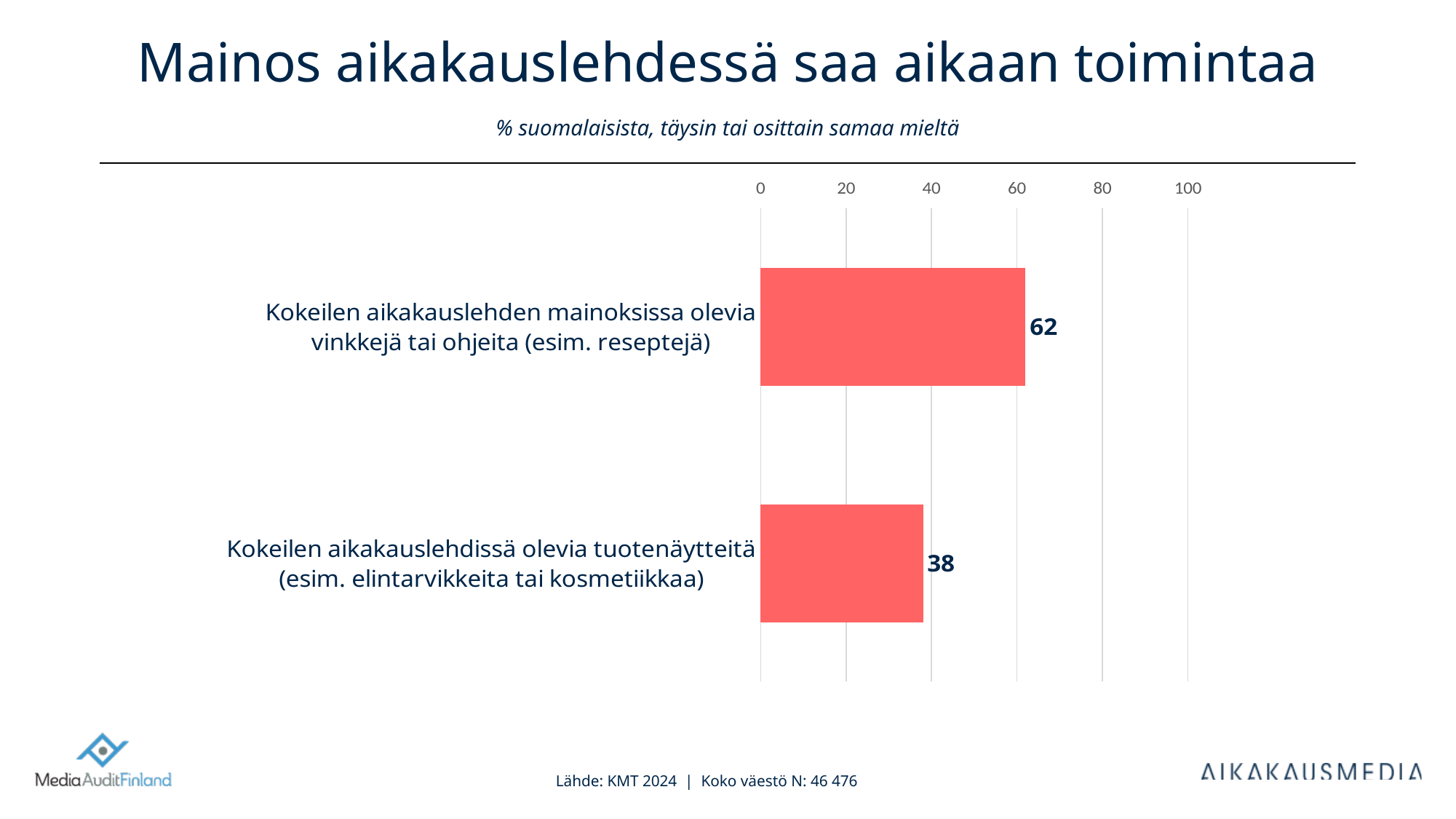
Is the value for "Kokeilen aikakauslehden mainoksissa olevia vinkkejä tai ohjeita" greater or less than 60? greater What is the value for "Kokeilen aikakauslehden mainoksissa olevia vinkkejä tai ohjeita (esim. reseptejä)"? 62 How many categories are shown in the chart? 2 Which category has the highest value? Kokeilen aikakauslehden mainoksissa olevia vinkkejä tai ohjeita (esim. reseptejä) What kind of chart is shown on the slide? bar chart Is the value for "Kokeilen aikakauslehdissä olevia tuotenäytteitä" greater or less than 40? less What is the highest value shown on the chart's axis? 100 Which category has the lowest value? Kokeilen aikakauslehdissä olevia tuotenäytteitä (esim. elintarvikkeita tai kosmetiikkaa) What is the difference between the value for trying tips or instructions from magazine ads and the value for trying product samples in magazines? 24 What is the title of the slide? Mainos aikakauslehdessä saa aikaan toimintaa Which is larger: the value for trying tips or instructions from magazine ads, or the value for trying product samples in magazines? Kokeilen aikakauslehden mainoksissa olevia vinkkejä tai ohjeita (esim. reseptejä) What is the value for "Kokeilen aikakauslehdissä olevia tuotenäytteitä (esim. elintarvikkeita tai kosmetiikkaa)"? 38